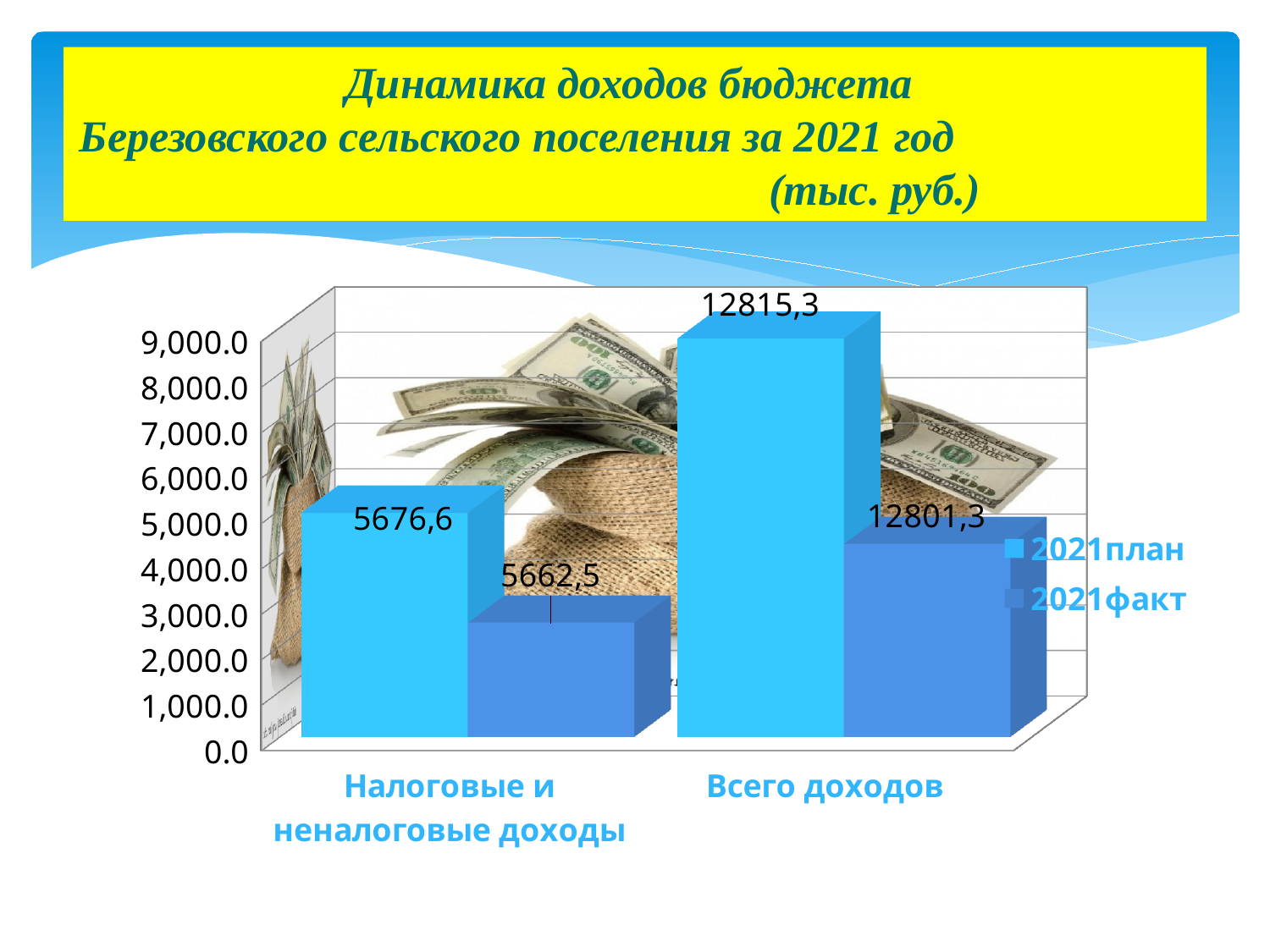
What is the 2021факт value for Налоговые и неналоговые доходы? 5662,5 What is the difference between the 2021план and 2021факт values for Всего доходов? 14,0 Which category has the highest 2021план value? Всего доходов Which is larger: the 2021план value for Всего доходов or the 2021план value for Налоговые и неналоговые доходы? Всего доходов Which category has the lowest 2021факт value? Налоговые и неналоговые доходы What is the 2021факт value for Всего доходов? 12801,3 What is the 2021план value for Налоговые и неналоговые доходы? 5676,6 How many series does the legend list? 2 What kind of chart is shown on the slide? Bar chart How many categories are shown on the x axis? 2 What is the difference between the 2021план and 2021факт values for Налоговые и неналоговые доходы? 14,1 What is the 2021план value for Всего доходов? 12815,3